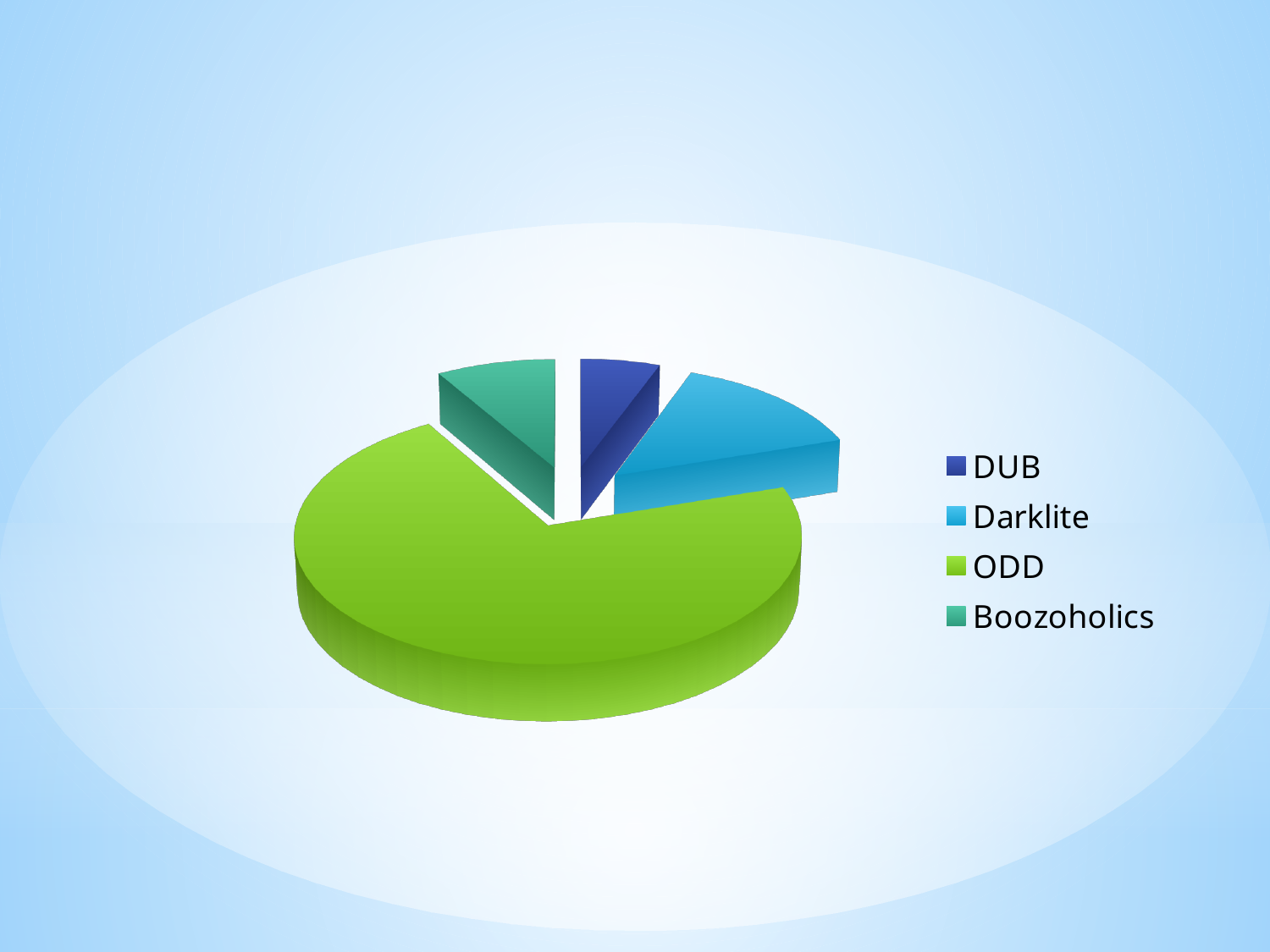
What kind of chart is shown on the slide? Pie chart Which slice is larger, Darklite or Boozoholics? Darklite Which legend entry is shown in dark blue? DUB Which slice is larger, Boozoholics or DUB? Boozoholics Which category has the smallest slice of the pie? DUB How many entries does the legend list? 4 Which slice is larger, ODD or Darklite? ODD Which category has the largest slice of the pie? ODD How many slices does the pie chart have? 4 What colour is the ODD slice? Green